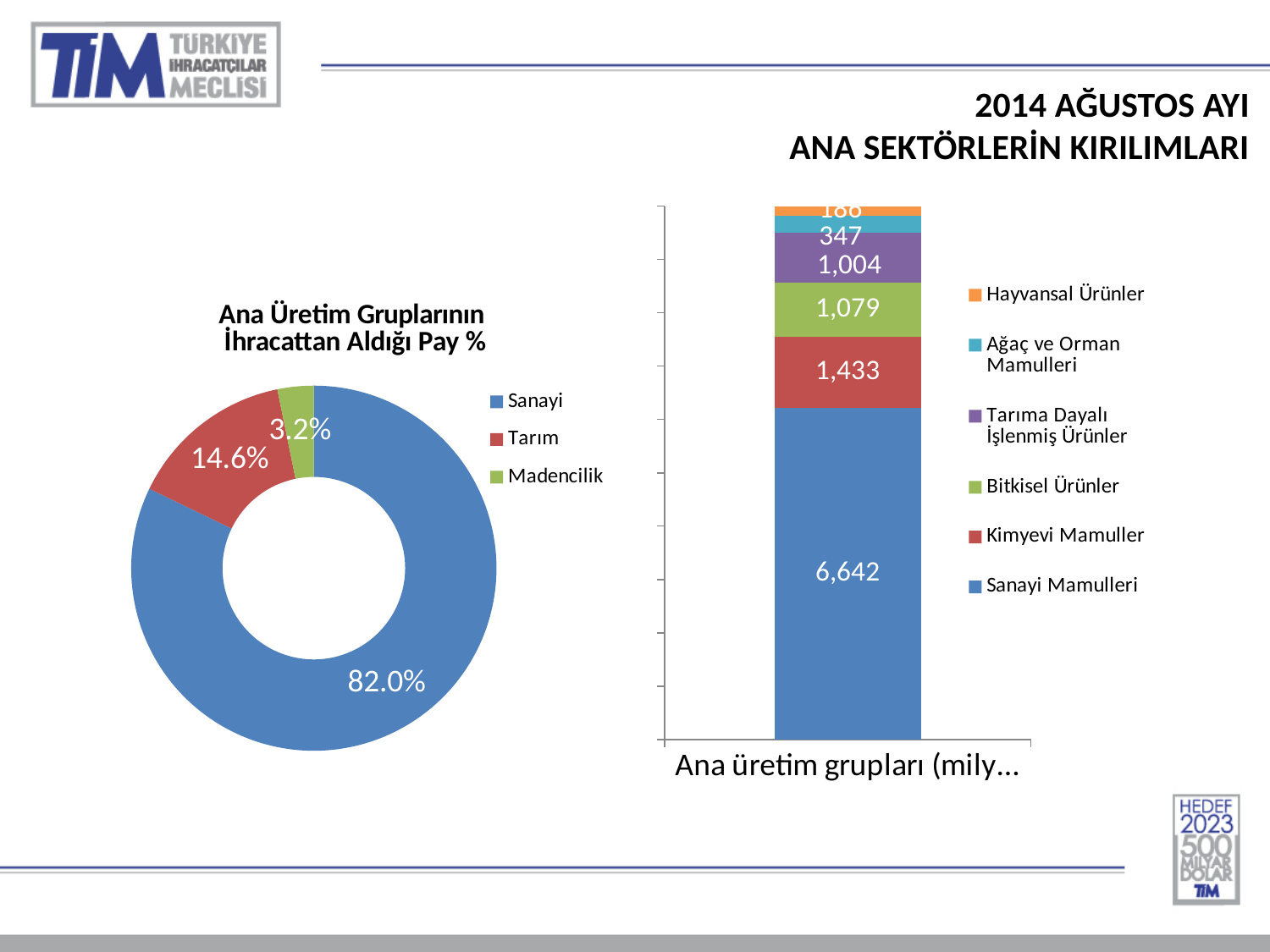
In the stacked bar chart on the right, how many series does the legend list? 6 In the doughnut chart 'Ana Üretim Gruplarının İhracattan Aldığı Pay %', what is the difference in percentage points between Tarım and Madencilik? 11.4 In the doughnut chart 'Ana Üretim Gruplarının İhracattan Aldığı Pay %', what share does Tarım have? 14.6% In the stacked bar chart on the right, what is the value for Kimyevi Mamuller? 1,433 In the stacked bar chart on the right, which segment is larger: Kimyevi Mamuller or Tarıma Dayalı İşlenmiş Ürünler? Kimyevi Mamuller In the stacked bar chart on the right, what is the value for Sanayi Mamulleri? 6,642 In the doughnut chart 'Ana Üretim Gruplarının İhracattan Aldığı Pay %', what share does Madencilik have? 3.2% In the doughnut chart 'Ana Üretim Gruplarının İhracattan Aldığı Pay %', which group has the smallest share? Madencilik In the stacked bar chart on the right, what is the value for Bitkisel Ürünler? 1,079 In the doughnut chart 'Ana Üretim Gruplarının İhracattan Aldığı Pay %', what share does Sanayi have? 82.0% In the stacked bar chart on the right, what is the value for Ağaç ve Orman Mamulleri? 347 In the doughnut chart 'Ana Üretim Gruplarının İhracattan Aldığı Pay %', how many groups are shown? 3